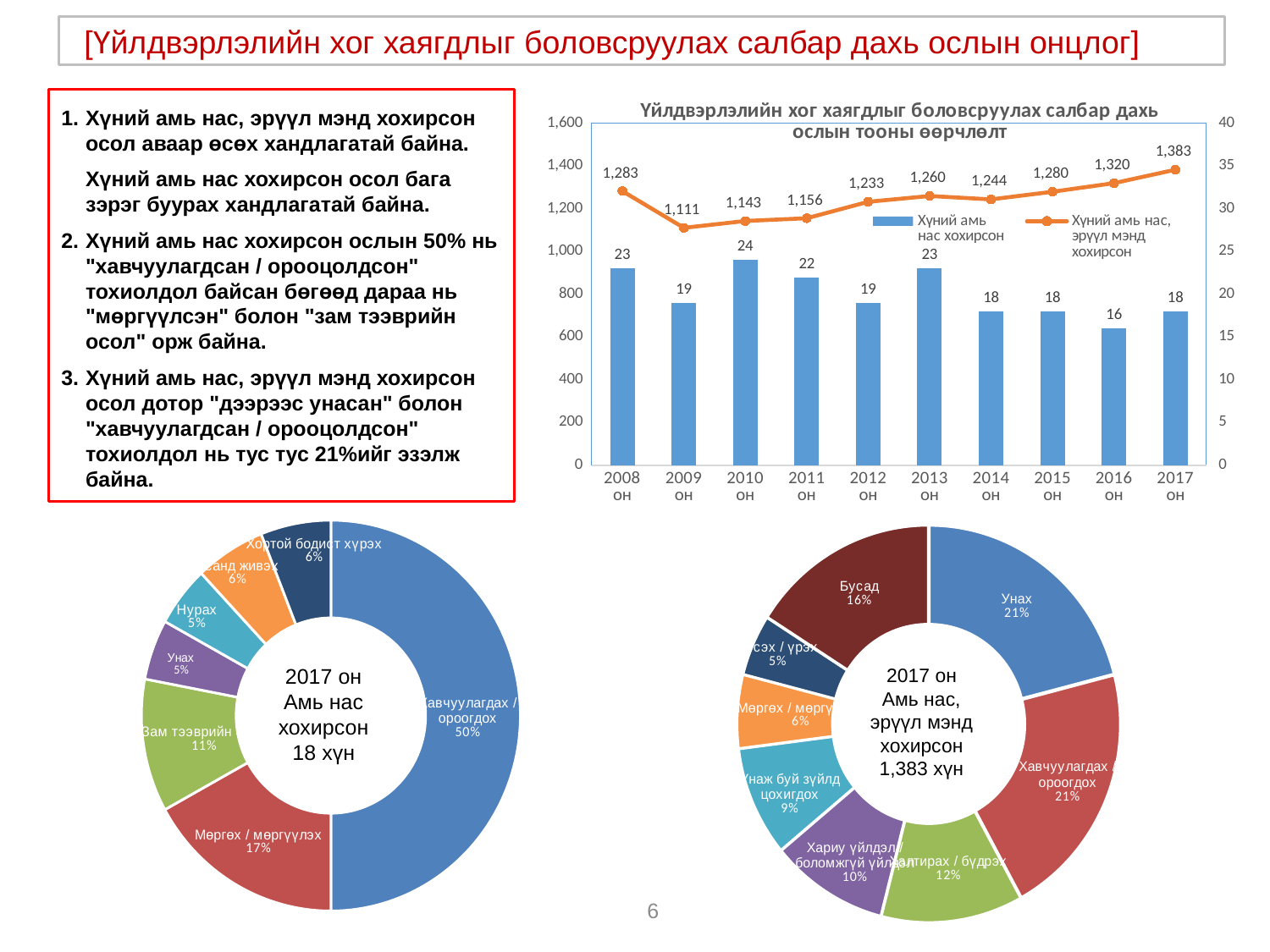
What type of chart is the bottom-right chart (2017 он Амь нас, эрүүл мэнд хохирсон 1,383 хүн)? Donut (pie) chart In the top-right chart, which year has the highest value on the line series (Хүний амь нас, эрүүл мэнд хохирсон)? 2017 он In the top-right chart, which year has the lowest bar value for Хүний амь нас хохирсон? 2016 он In the bottom-left donut chart (2017 он Амь нас хохирсон 18 хүн), what percentage is shown for Зам тээврийн? 11% In the bottom-left donut chart (2017 он Амь нас хохирсон 18 хүн), what share does Хавчуулагдах / ороогдох have? 50% In the top-right chart, what is the difference between the line values for 2017 он and 2008 он? 100 In the bottom-right donut chart (2017 он Амь нас, эрүүл мэнд хохирсон 1,383 хүн), what percentage is shown for Бусад? 16% How many series does the legend of the top-right chart list? 2 How many years are shown on the x axis of the top-right chart? 10 In the top-right chart, what is the value of the line series (Хүний амь нас, эрүүл мэнд хохирсон) for 2017 он? 1,383 In the top-right chart, is the bar value for 2011 он larger or smaller than the bar value for 2014 он? larger In the top-right chart, what is the value of the bar series (Хүний амь нас хохирсон) for 2010 он? 24